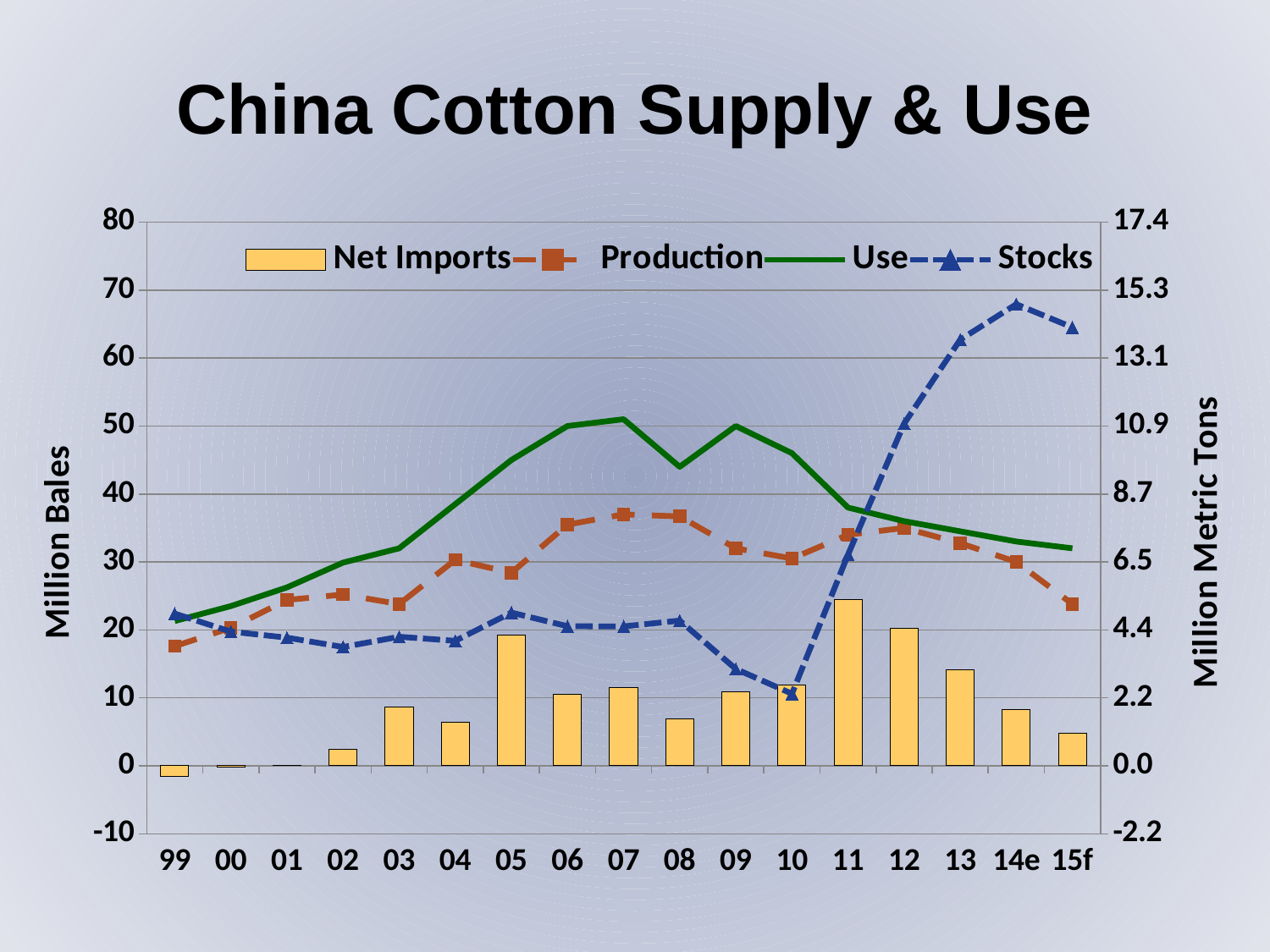
Is the value for Stocks in 14e greater or less than 60 million bales? greater Is the value for Net Imports in 11 greater or less than 20 million bales? greater In which year are Stocks highest? 14e In which year are Net Imports highest? 11 Do Stocks rise or fall from 10 to 14e? Rise How many series does the legend list? 4 How many years are shown on the x axis? 17 What kind of chart is this? Combined bar and line chart Which series is plotted as bars? Net Imports In which year are Stocks lowest? 10 What is the title of the chart? China Cotton Supply & Use Which is larger in 07, Use or Production? Use